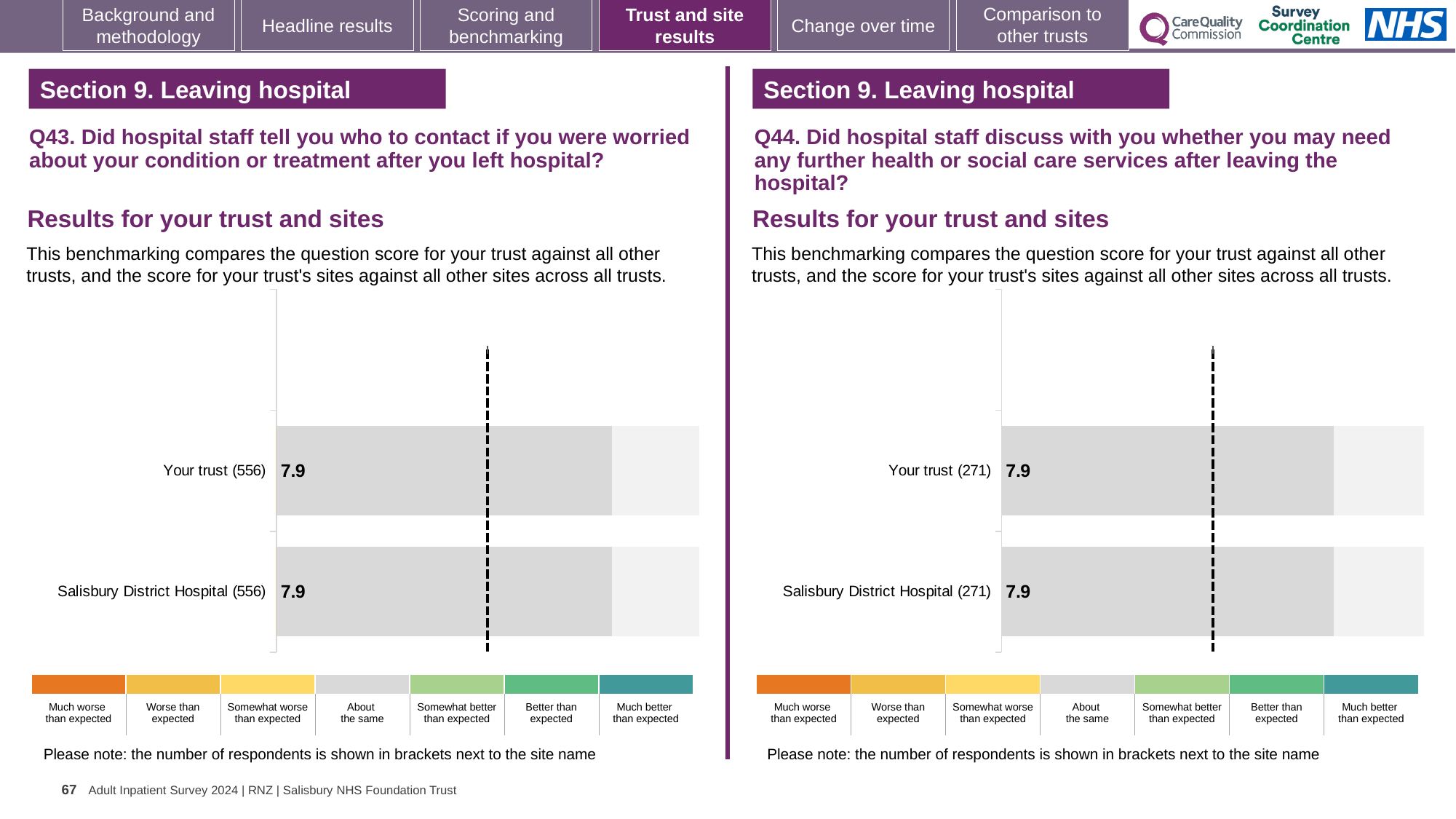
On the Q44 chart (right), how many respondents are shown in brackets next to Salisbury District Hospital? 271 On the Q44 chart (right), what is the difference between the score for Your trust and the score for Salisbury District Hospital? 0.0 On the Q44 chart (right), what is the score for Salisbury District Hospital? 7.9 On the Q43 chart (left), what is the score for Your trust? 7.9 What kind of chart is used on the Q43 chart (left)? Bar chart On the Q43 chart (left), what is the difference between the score for Your trust and the score for Salisbury District Hospital? 0.0 How many bars are plotted on the Q43 chart (left)? 2 On the Q43 chart (left), what is the score for Salisbury District Hospital? 7.9 On the Q44 chart (right), is the score for Your trust greater or less than 5? greater On the Q44 chart (right), what is the score for Your trust? 7.9 How many bars are plotted on the Q44 chart (right)? 2 On the Q43 chart (left), how many respondents are shown in brackets next to Your trust? 556